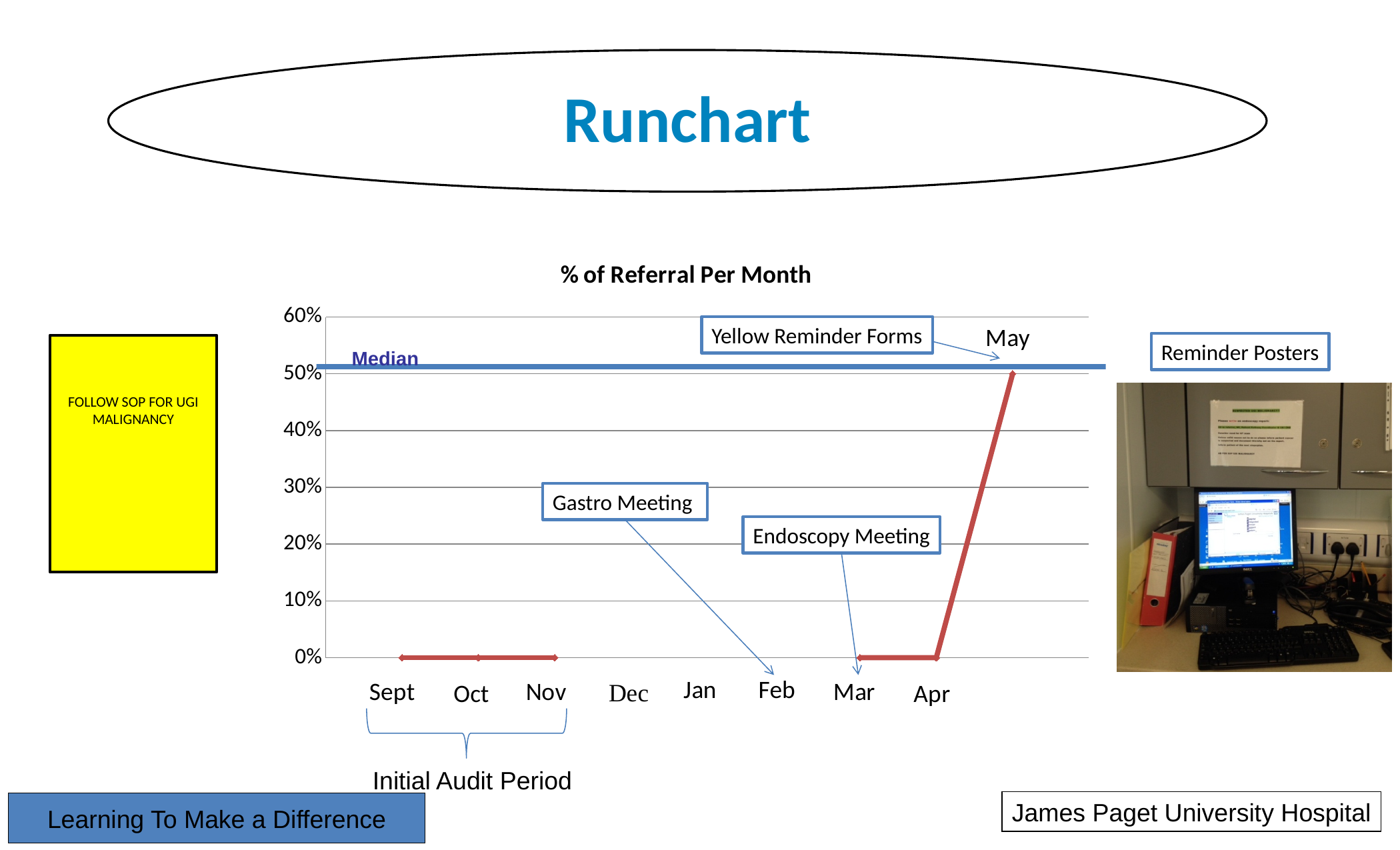
What kind of chart is shown on the slide? line chart Which is larger, the value for Apr or the value for May? May Is the value for May greater or less than 40%? greater What is the highest value shown on the y axis? 60% Which month has the highest value? May What is the label on the horizontal blue line near 50%? Median What is the value for Sept? 0% What is the value for Nov? 0% How many months have a plotted value of 0%? 5 What is the title of the chart? % of Referral Per Month What is the value for Apr? 0% Does the line rise or fall between Apr and May? rise